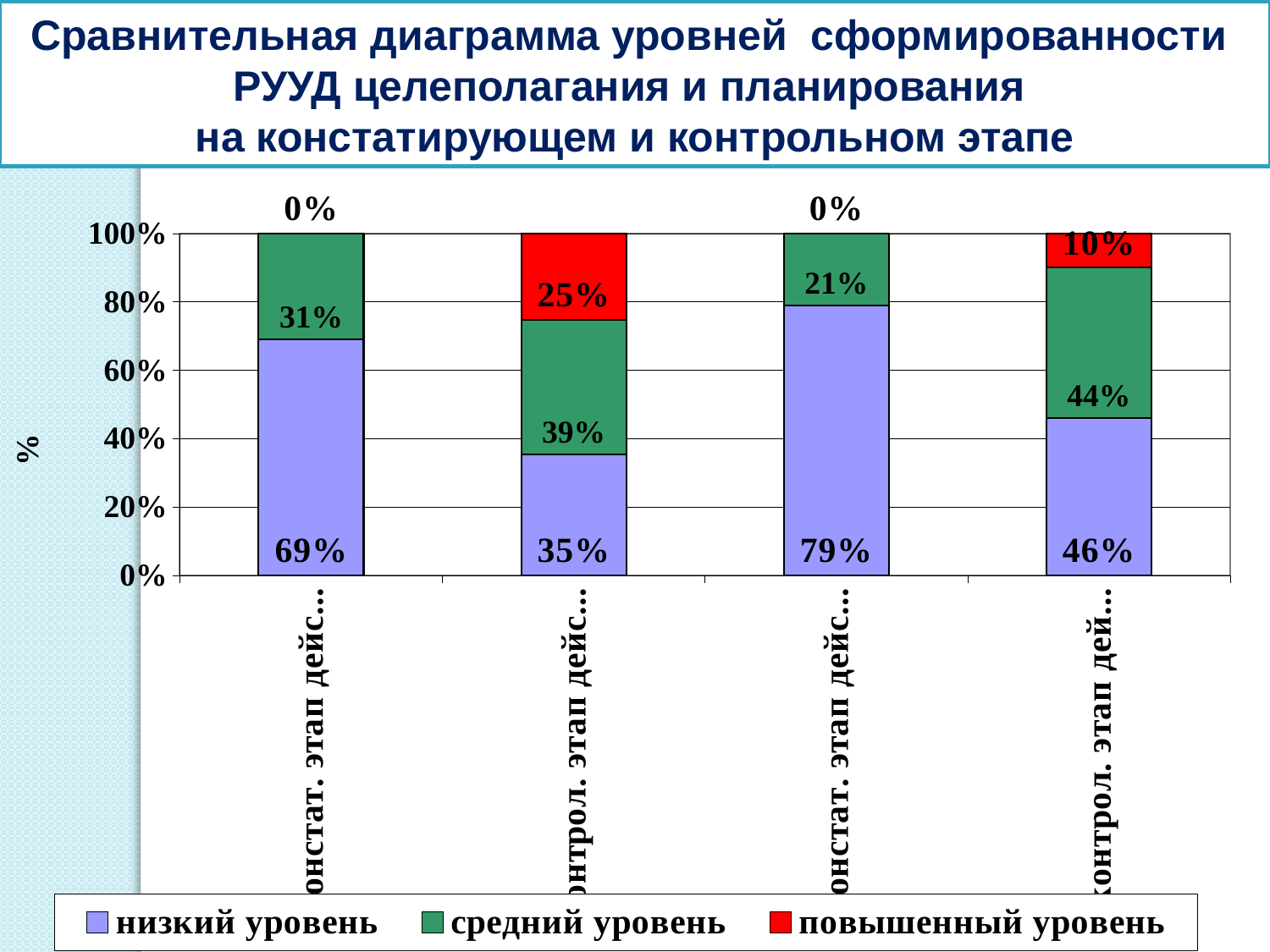
Which bar has the highest value for 'низкий уровень'? the third bar from the left (79%) What kind of chart is shown on the slide? stacked bar chart How many bars are plotted in the chart? 4 What colour represents 'повышенный уровень' in the legend? red What is the value of 'повышенный уровень' in the second bar from the left? 25% What is the value of 'средний уровень' in the fourth (rightmost) bar? 44% Which bar has the lowest value for 'низкий уровень'? the second bar from the left (35%) What is the difference between the 'низкий уровень' values of the third bar and the first bar? 10% Which is larger: the 'средний уровень' value in the second bar or in the fourth bar? the fourth bar (44%) How many series does the legend list? 3 What is the value of 'низкий уровень' in the first (leftmost) bar? 69% What is the value of 'повышенный уровень' in the rightmost bar? 10%